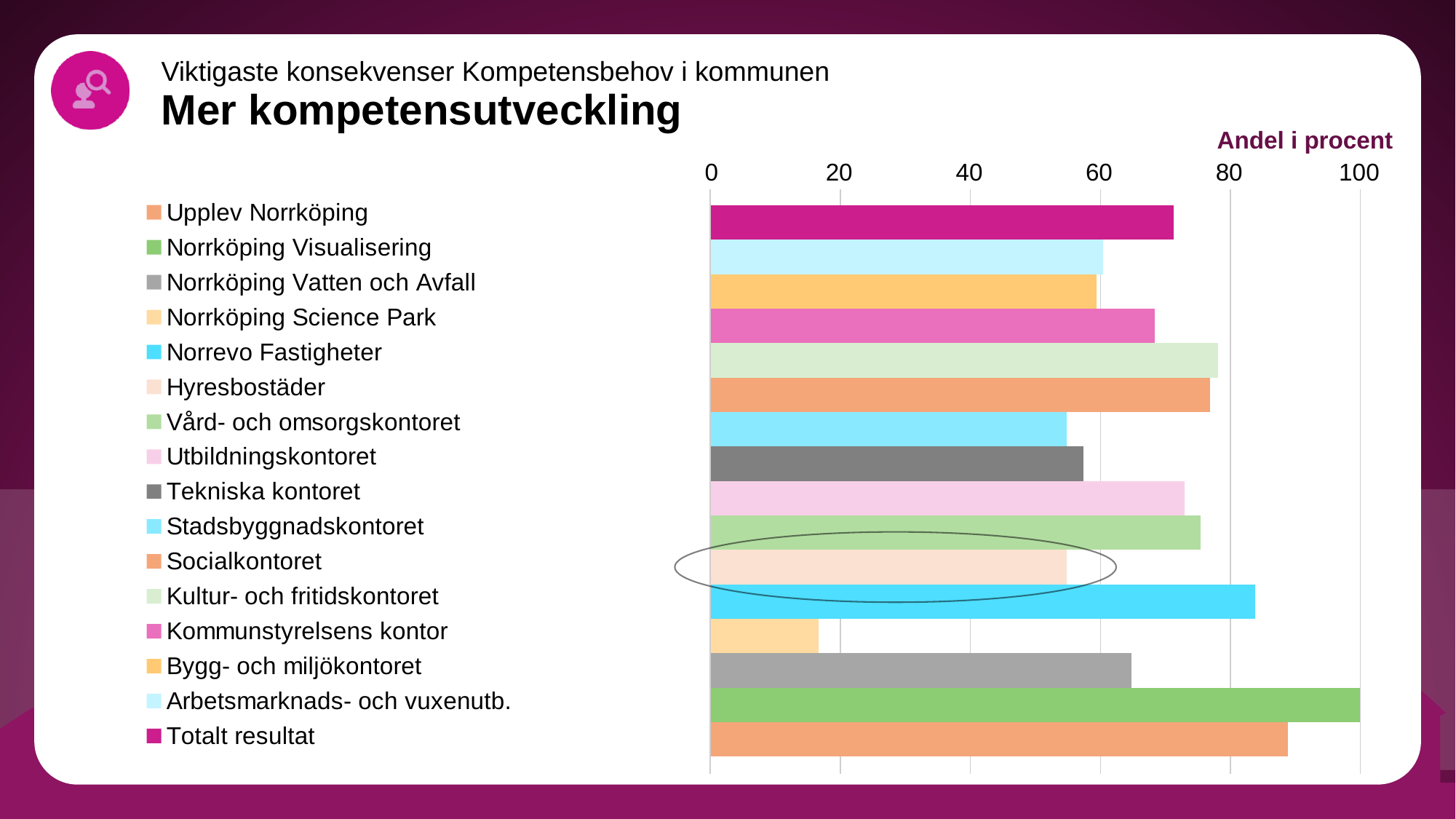
What kind of chart is shown on the slide? bar chart Is the value for Norrevo Fastigheter greater or less than 80? greater Which is larger, the value for Norrevo Fastigheter or the value for Totalt resultat? Norrevo Fastigheter What is the axis title shown above the chart's value axis? Andel i procent Which entry has the highest value in the chart? Norrköping Visualisering Which entry has the lowest value in the chart? Norrköping Science Park How many entries does the legend list? 16 How many bars are plotted in the chart? 16 Is the value for Stadsbyggnadskontoret greater or less than 60? less Is the value for Totalt resultat greater or less than 60? greater Which is larger, the value for Upplev Norrköping or the value for Norrköping Vatten och Avfall? Upplev Norrköping